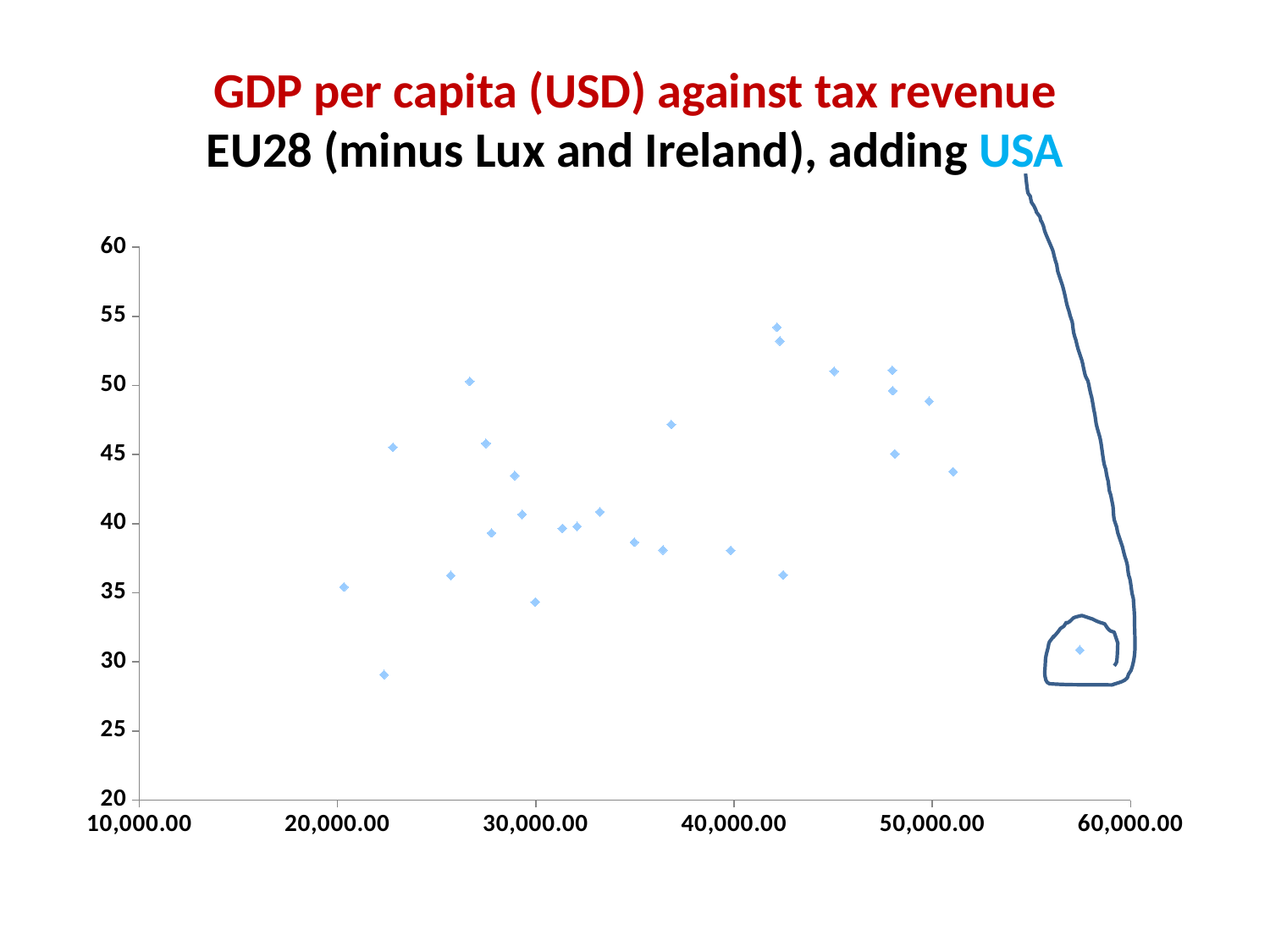
What is the highest value shown on the vertical axis? 60 Is the GDP per capita of the leftmost point on the chart greater or less than 30,000.00? less Is the highest tax revenue value plotted on the chart greater or less than 50? greater Does the circled USA point have a higher or lower tax revenue than the point at roughly 42,000 GDP per capita near the top of the chart? lower How many data points are plotted on the chart? 27 Is the tax revenue value for the circled USA point greater or less than 35? less What kind of chart is shown on the slide? scatter chart What is the title of the chart? GDP per capita (USD) against tax revenue Which country's data point is circled by hand on the chart? USA